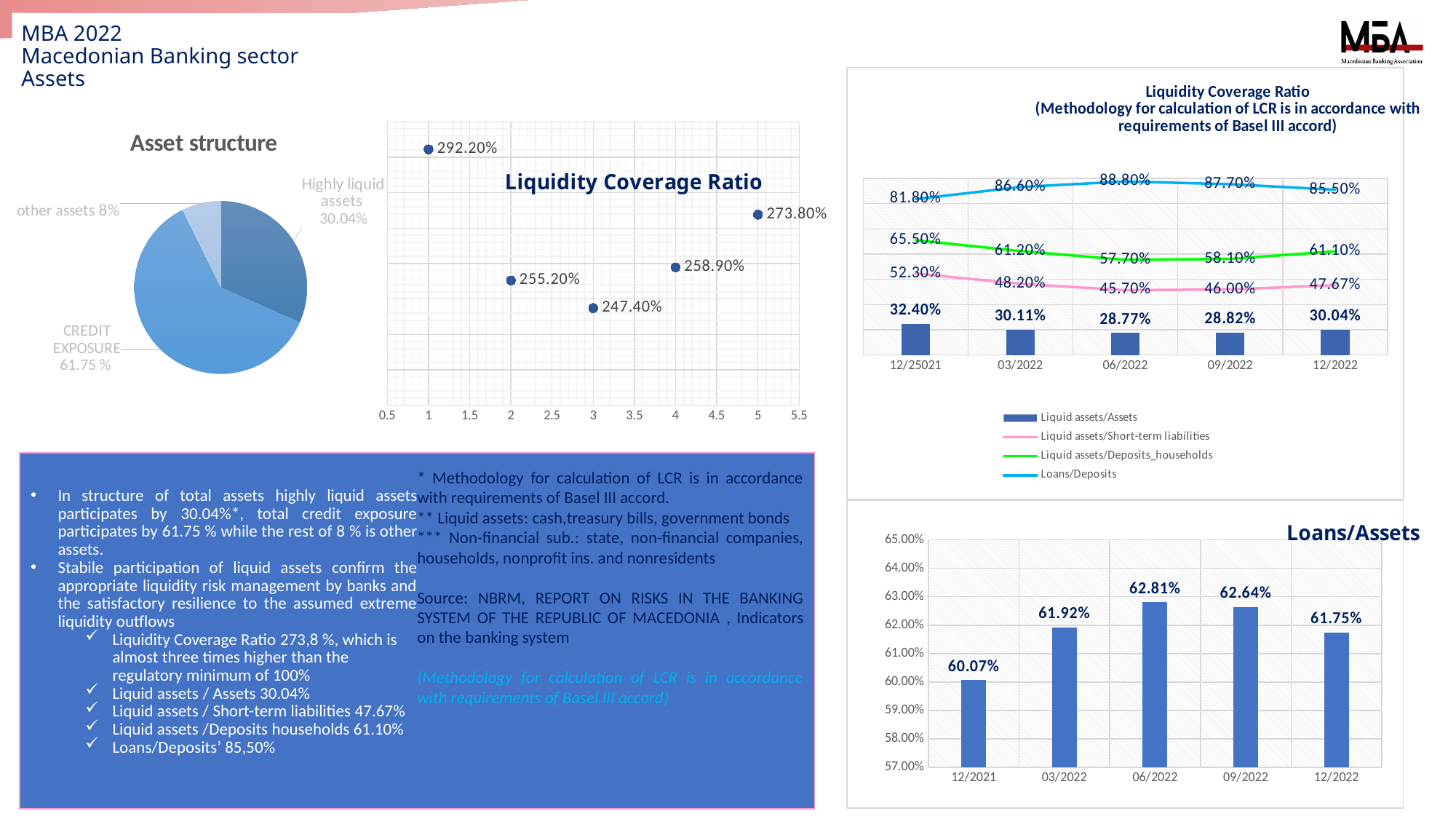
In the Liquidity Coverage Ratio (Basel III) chart, how many series does the legend list? 4 In the Liquidity Coverage Ratio scatter chart, what is the highest value shown? 292.20% In the Loans/Assets chart, what is the difference between the 06/2022 value and the 12/2021 value? 2.74% In the Liquidity Coverage Ratio (Basel III) chart, what is the Loans/Deposits value for 06/2022? 88.80% In the Liquidity Coverage Ratio scatter chart, how many data points are plotted? 5 What kind of chart is the Loans/Assets chart? Bar chart In the Asset structure pie chart, which slice is the largest? CREDIT EXPOSURE In the Loans/Assets chart, which period has the highest value? 06/2022 In the Asset structure pie chart, what is the share of other assets? 8% In the Liquidity Coverage Ratio scatter chart, what is the lowest value shown? 247.40% In the Asset structure pie chart, what share do highly liquid assets have? 30.04% In the Liquidity Coverage Ratio (Basel III) chart, what is the Liquid assets/Short-term liabilities value for 12/2022? 47.67%